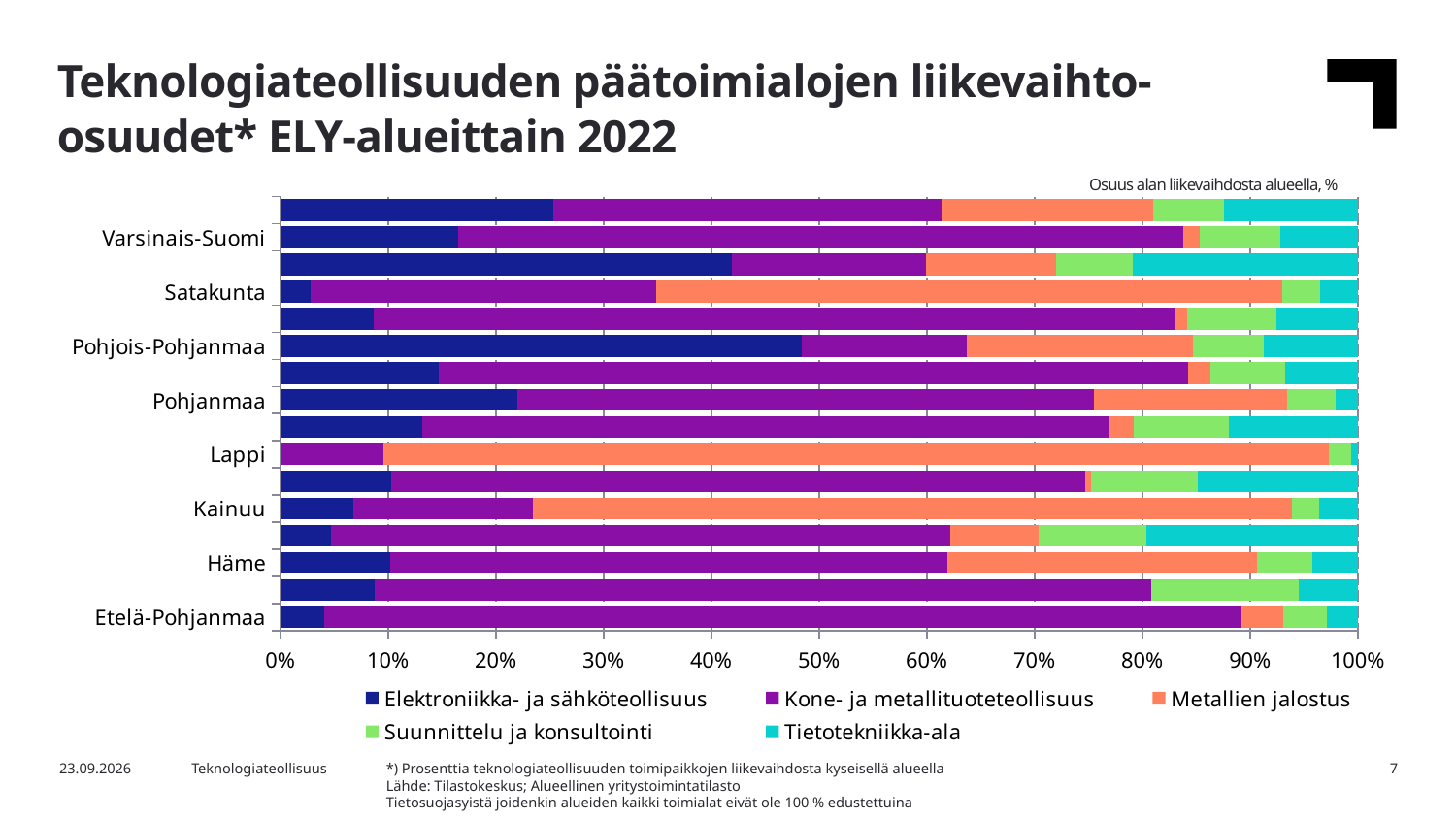
What text is shown above the chart describing the measure plotted? Osuus alan liikevaihdosta alueella, % Which region has the larger Elektroniikka- ja sähköteollisuus share, Pohjois-Pohjanmaa or Satakunta? Pohjois-Pohjanmaa Is the Kone- ja metallituoteteollisuus share for Etelä-Pohjanmaa greater or less than 80%? greater How many series does the legend list? 5 Is the Metallien jalostus share for Lappi greater or less than 80%? greater Which region has the larger Metallien jalostus share, Lappi or Varsinais-Suomi? Lappi Is the Metallien jalostus share for Kainuu greater or less than 60%? greater What kind of chart is shown on the slide? Stacked bar chart Which region has the highest Elektroniikka- ja sähköteollisuus share? Pohjois-Pohjanmaa